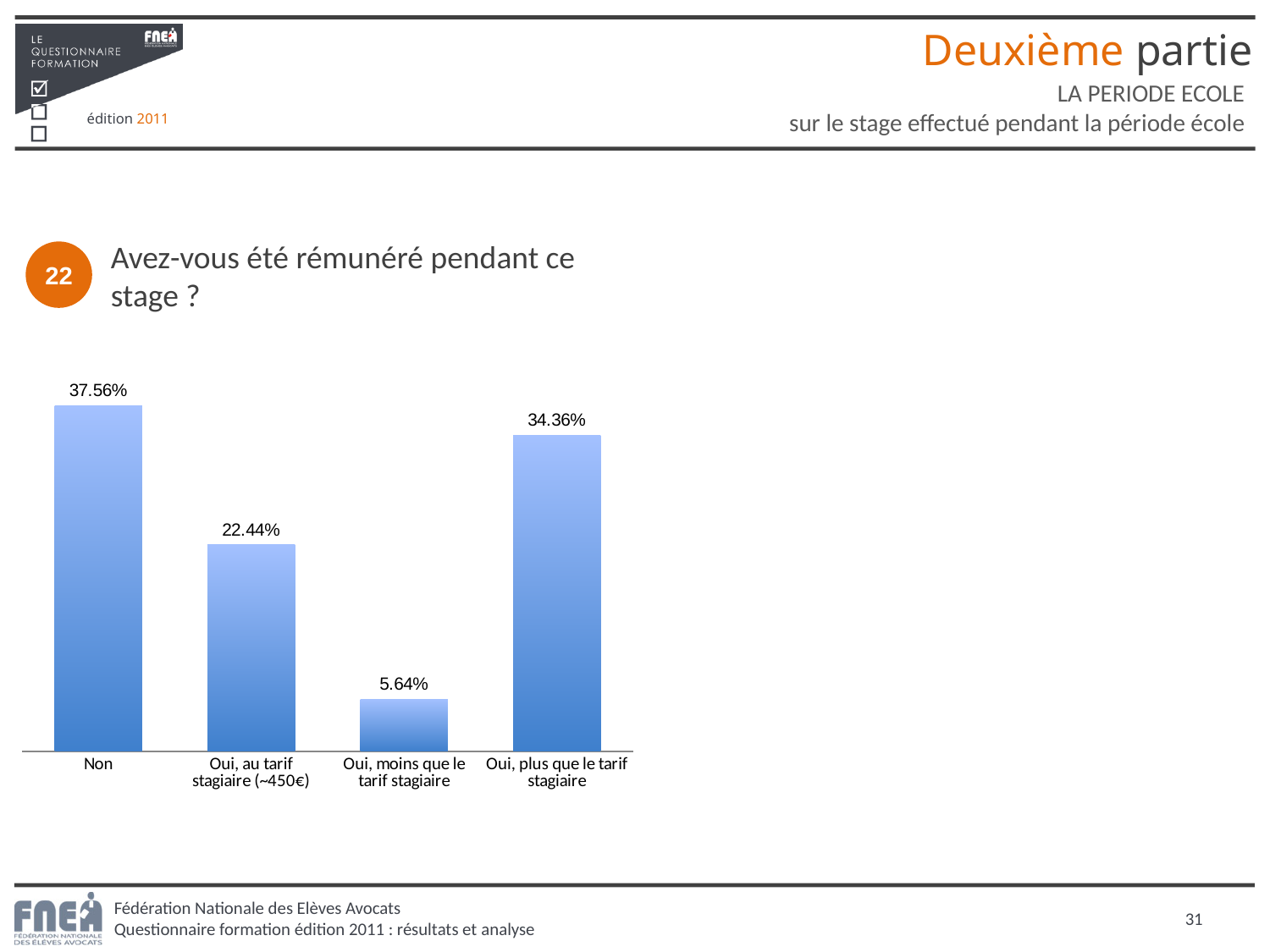
What kind of chart is shown on the slide? Bar chart What is the value for "Oui, plus que le tarif stagiaire"? 34.36% What is the value for "Oui, au tarif stagiaire (~450€)"? 22.44% How many categories are shown in the chart? 4 Which category has the lowest value? Oui, moins que le tarif stagiaire What is the difference between the values for "Oui, au tarif stagiaire (~450€)" and "Oui, moins que le tarif stagiaire"? 16.80% Which is larger, the value for "Oui, au tarif stagiaire (~450€)" or the value for "Oui, plus que le tarif stagiaire"? Oui, plus que le tarif stagiaire What question does the chart on the slide answer? Avez-vous été rémunéré pendant ce stage ? What is the value for "Oui, moins que le tarif stagiaire"? 5.64% Which category has the highest value? Non What is the value for "Non"? 37.56% What is the difference between the values for "Non" and "Oui, plus que le tarif stagiaire"? 3.20%